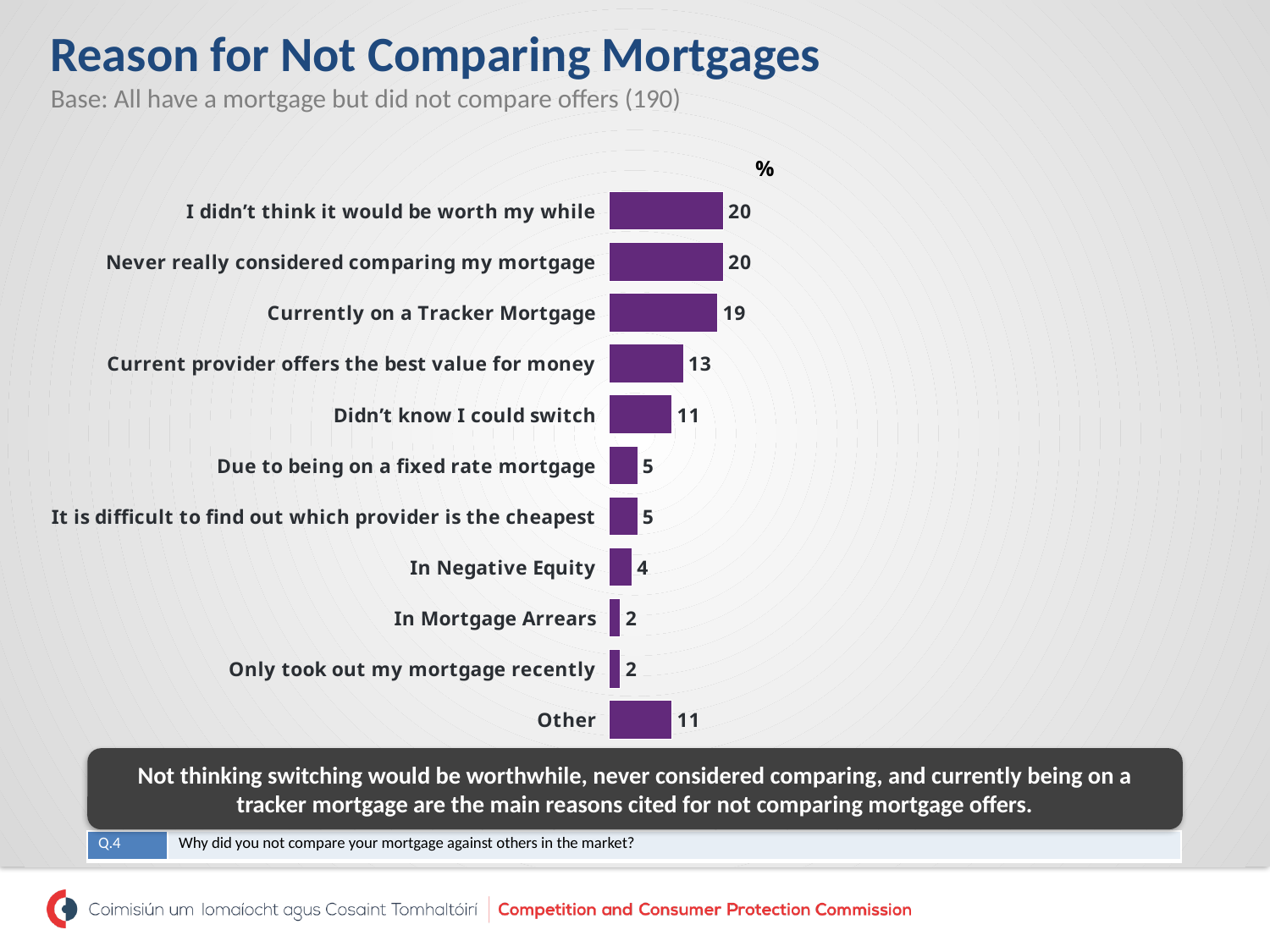
What percentage of respondents said they are currently on a tracker mortgage? 19 What type of chart is shown on the slide? Bar chart Which is larger: 'Other' or 'In Mortgage Arrears'? Other What is the difference between 'Currently on a Tracker Mortgage' and 'Current provider offers the best value for money'? 6 What percentage said they didn't know they could switch? 11 What is the difference between 'I didn't think it would be worth my while' and 'Didn't know I could switch'? 9 What is the value for 'Other'? 11 What is the value for 'In Negative Equity'? 4 What is the base size stated under the chart title? 190 Which is larger: 'Due to being on a fixed rate mortgage' or 'In Negative Equity'? Due to being on a fixed rate mortgage What is the value for 'Current provider offers the best value for money'? 13 How many reasons are listed in the chart? 11